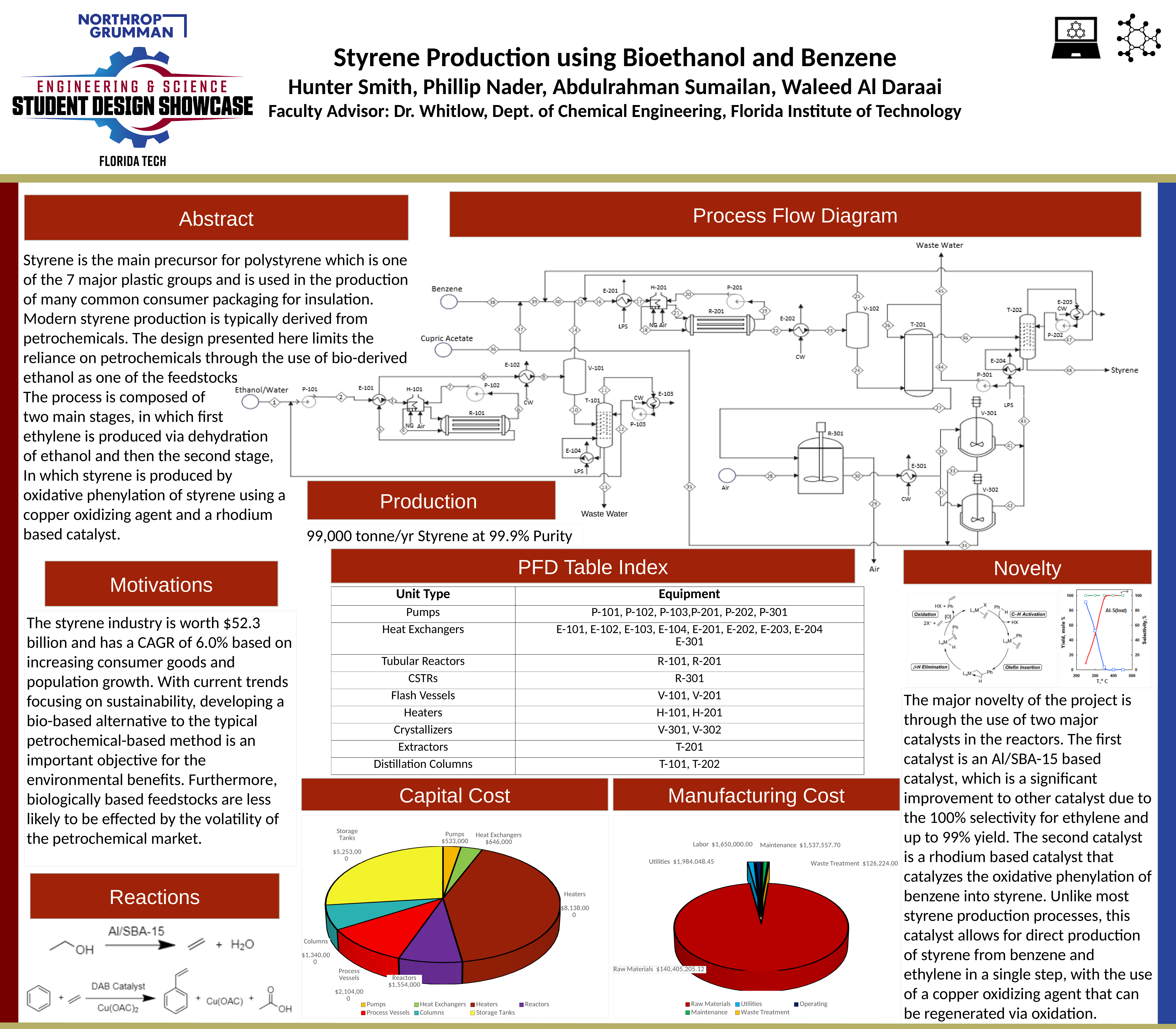
What kind of chart is the Capital Cost chart? pie chart How many entries does the legend of the Manufacturing Cost chart list? 5 How many entries does the legend of the Capital Cost chart list? 7 In the Capital Cost chart, which category has the highest cost? Heaters In the Capital Cost chart, what is the value for Storage Tanks? $5,253,000 In the Capital Cost chart, which category has the lowest cost? Pumps In the Manufacturing Cost chart, what is the difference between the Labor value and the Maintenance value? $112,442.30 In the Manufacturing Cost chart, what is the value for Raw Materials? $140,405,205.12 In the Manufacturing Cost chart, which category has the smallest labelled value? Waste Treatment In the Capital Cost chart, which is larger, Process Vessels or Columns? Process Vessels In the Capital Cost chart, what is the difference between the Heat Exchangers value and the Pumps value? $113,000 In the Capital Cost chart, what is the value for Heaters? $8,138,000